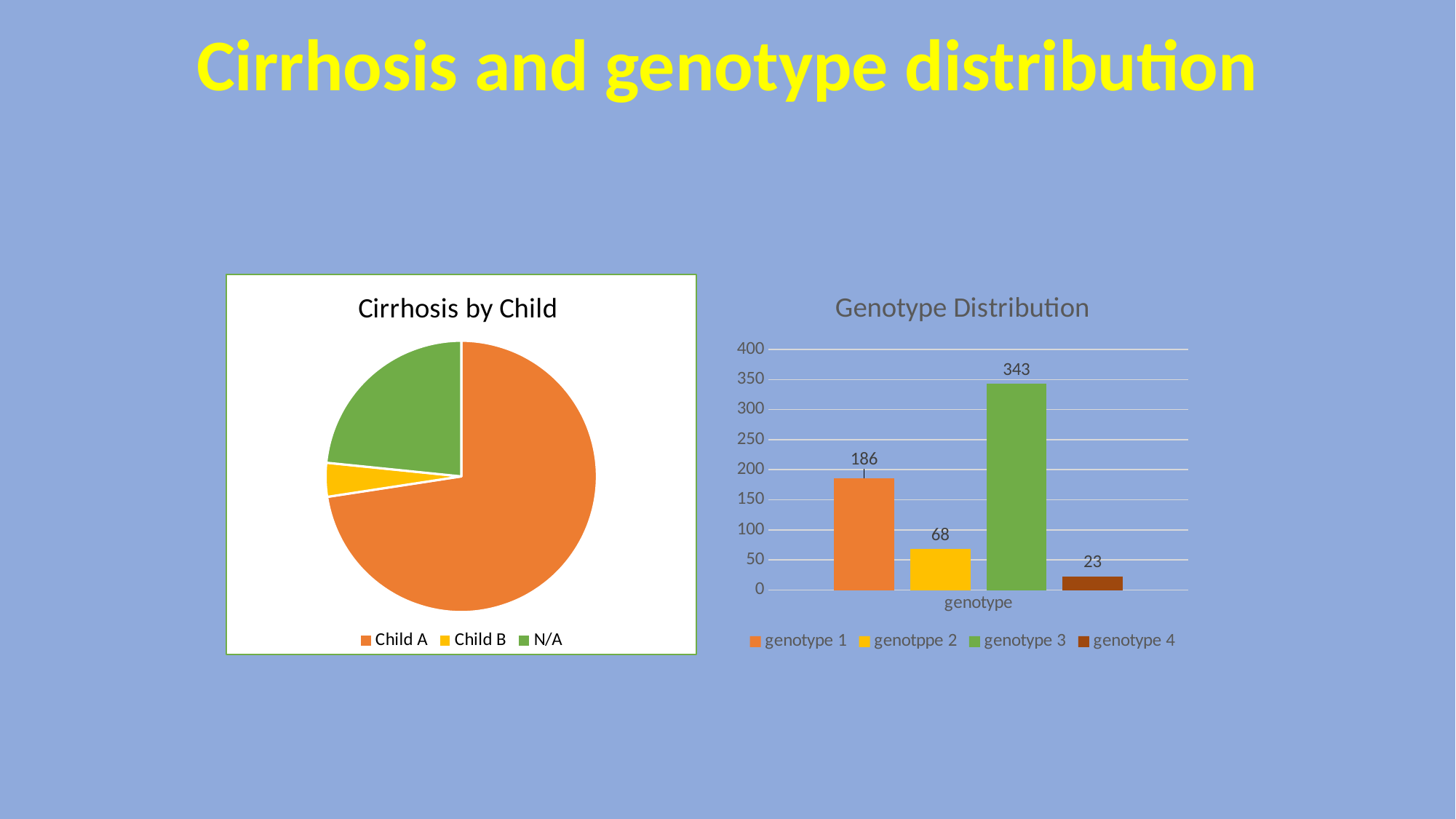
In the Cirrhosis by Child chart, which slice is the largest? Child A What kind of chart is the Genotype Distribution chart? bar chart In the Genotype Distribution chart, how many series does the legend list? 4 In the Genotype Distribution chart, which is larger, genotype 1 or genotppe 2? genotype 1 In the Genotype Distribution chart, what is the difference between genotype 3 and genotype 1? 157 In the Genotype Distribution chart, what is the value for genotype 4? 23 What kind of chart is the Cirrhosis by Child chart? pie chart In the Genotype Distribution chart, which genotype has the highest value? genotype 3 In the Genotype Distribution chart, which genotype has the lowest value? genotype 4 In the Genotype Distribution chart, what is the value for genotype 1? 186 In the Cirrhosis by Child chart, how many slices does the pie have? 3 In the Genotype Distribution chart, what is the value for genotype 3? 343